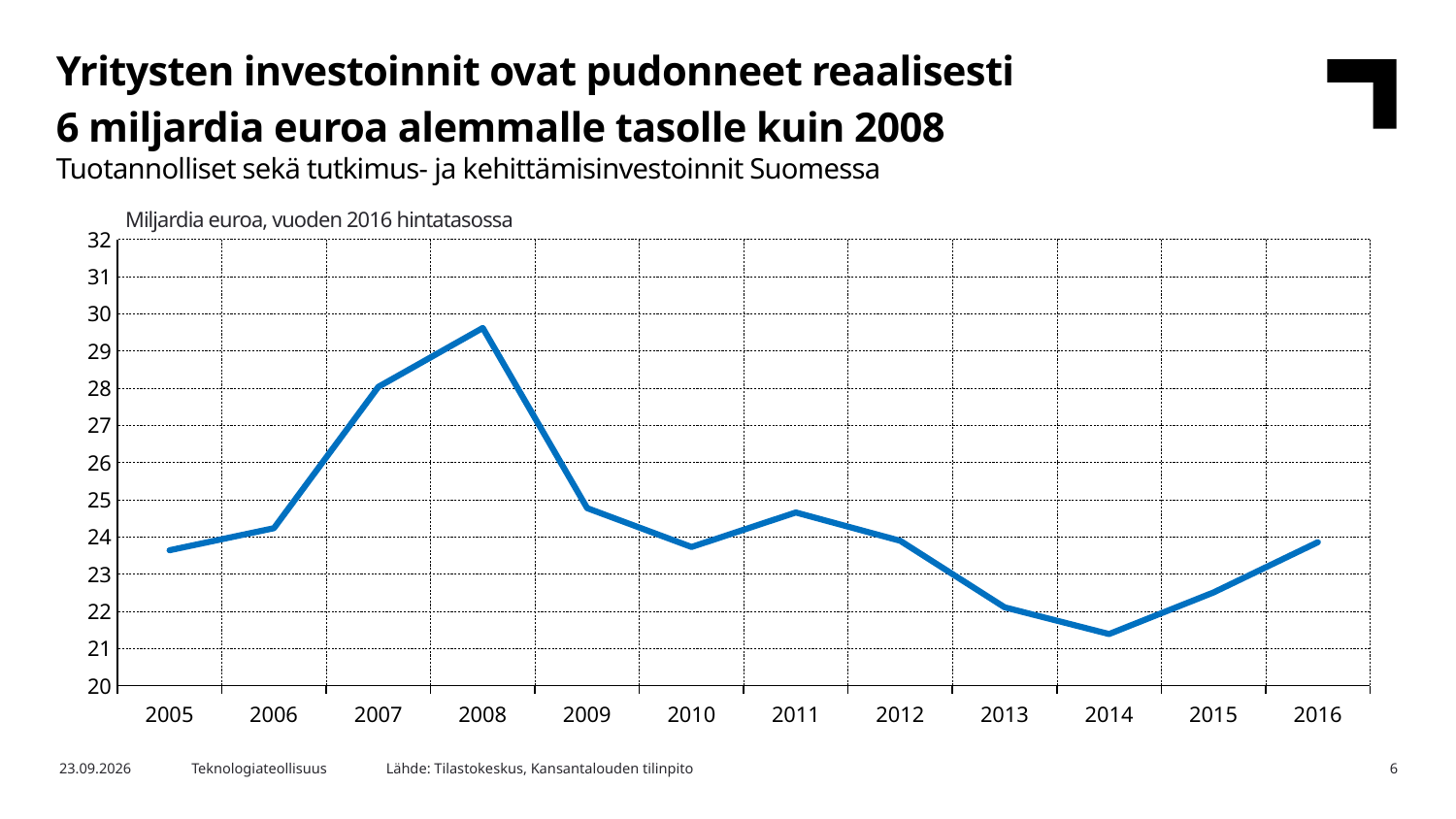
Which is larger, the value for 2008 or the value for 2014? 2008 Do the values rise or fall from 2005 to 2008? rise What unit label is shown above the y axis of the chart? Miljardia euroa, vuoden 2016 hintatasossa Is the value for 2014 greater or less than 22? less Is the value for 2007 greater or less than 27? greater What kind of chart is shown on the slide? Line chart Is the value for 2013 greater or less than 23? less Which year has the lowest value in the chart? 2014 Do the values rise or fall from 2008 to 2014? fall Which year has the highest value in the chart? 2008 How many years are plotted on the x axis of the chart? 12